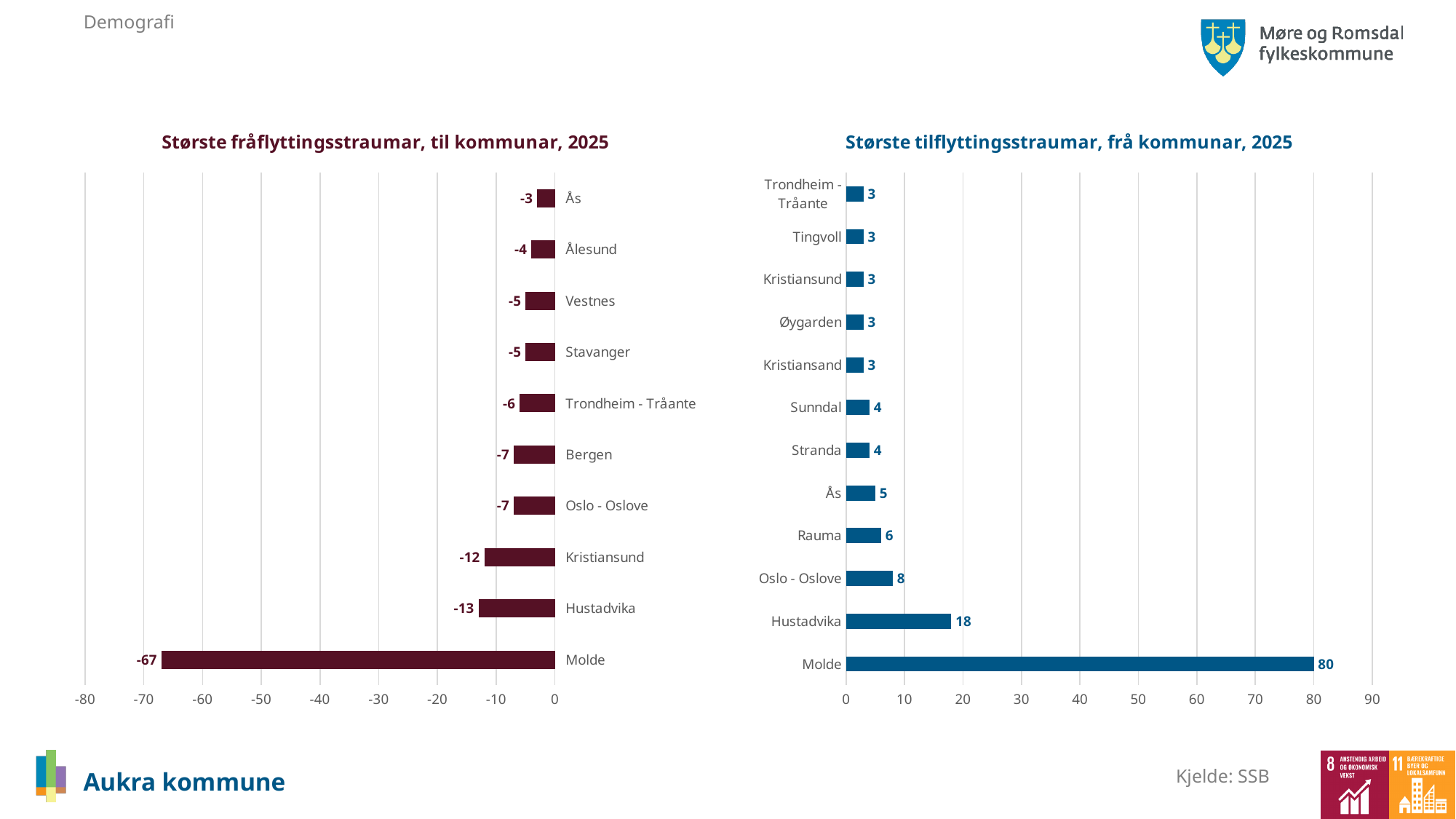
In the chart 'Største tilflyttingsstraumar, frå kommunar, 2025', which is larger, the value for Oslo - Oslove or the value for Ås? Oslo - Oslove How many categories are shown in the chart 'Største tilflyttingsstraumar, frå kommunar, 2025'? 12 In the chart 'Største fråflyttingsstraumar, til kommunar, 2025', what is the value for Molde? -67 In the chart 'Største tilflyttingsstraumar, frå kommunar, 2025', what is the difference between the values for Molde and Hustadvika? 62 In the chart 'Største tilflyttingsstraumar, frå kommunar, 2025', which category has the highest value? Molde How many categories are shown in the chart 'Største fråflyttingsstraumar, til kommunar, 2025'? 10 In the chart 'Største tilflyttingsstraumar, frå kommunar, 2025', what is the value for Hustadvika? 18 In the chart 'Største fråflyttingsstraumar, til kommunar, 2025', what is the difference between the values for Hustadvika and Kristiansund? 1 What kind of chart is the chart on the right side of the slide? Bar chart In the chart 'Største fråflyttingsstraumar, til kommunar, 2025', which category has the lowest (most negative) value? Molde In the chart 'Største fråflyttingsstraumar, til kommunar, 2025', what is the value for Kristiansund? -12 In the chart 'Største tilflyttingsstraumar, frå kommunar, 2025', what is the value for Rauma? 6